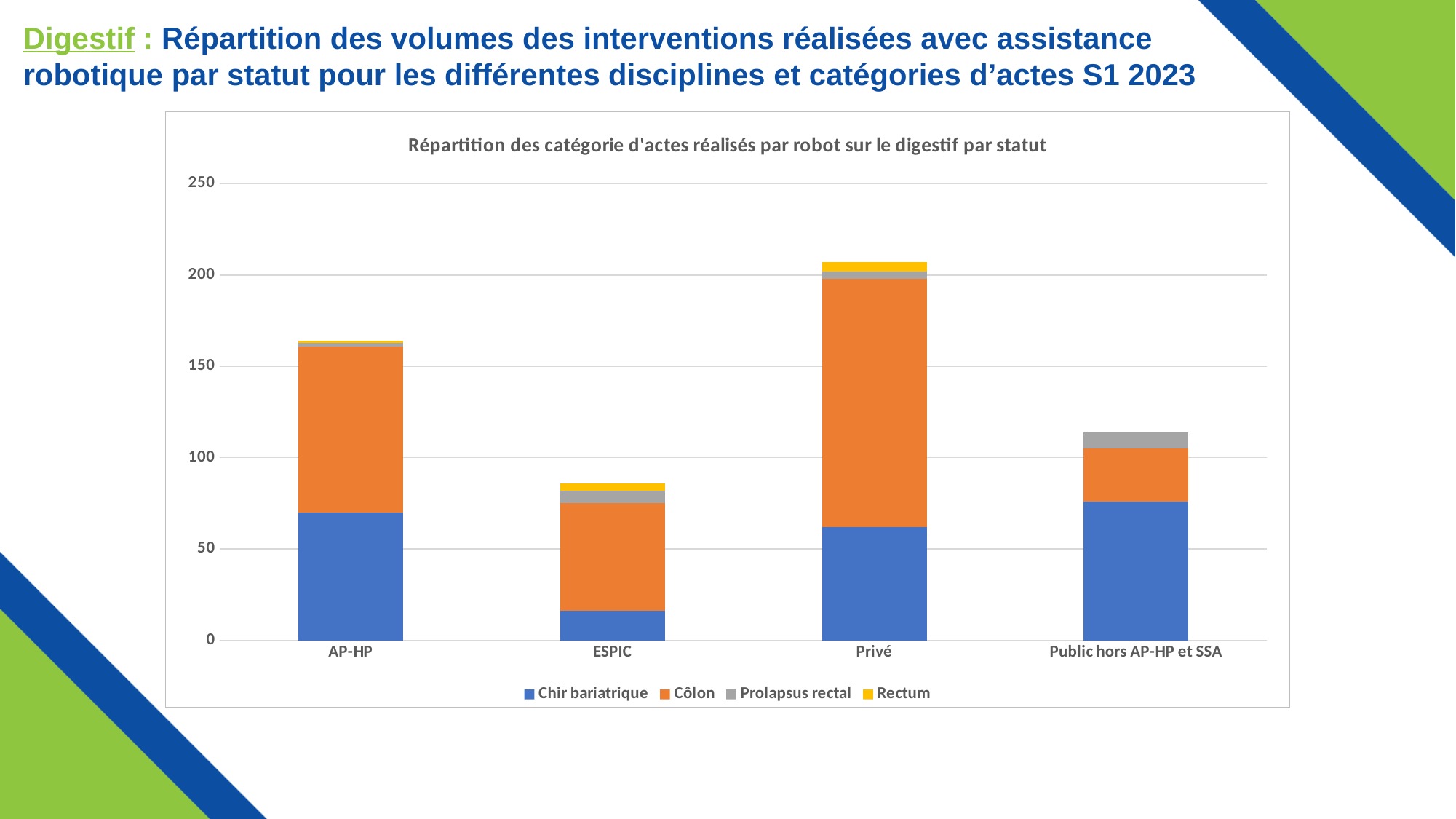
What kind of chart is shown on the slide? stacked bar chart How many status categories are shown on the x axis? 4 Is the total stacked value for Privé greater or less than 200? greater Which status has the shortest stacked bar overall? ESPIC How many series does the legend list? 4 Is the total stacked value for AP-HP greater or less than 150? greater Which status has the smallest Chir bariatrique segment? ESPIC Which status has the tallest stacked bar overall? Privé Is the total stacked value for ESPIC greater or less than 100? less What is the title of the chart? Répartition des catégorie d'actes réalisés par robot sur le digestif par statut Which is larger: the total stacked bar for AP-HP or for Public hors AP-HP et SSA? AP-HP